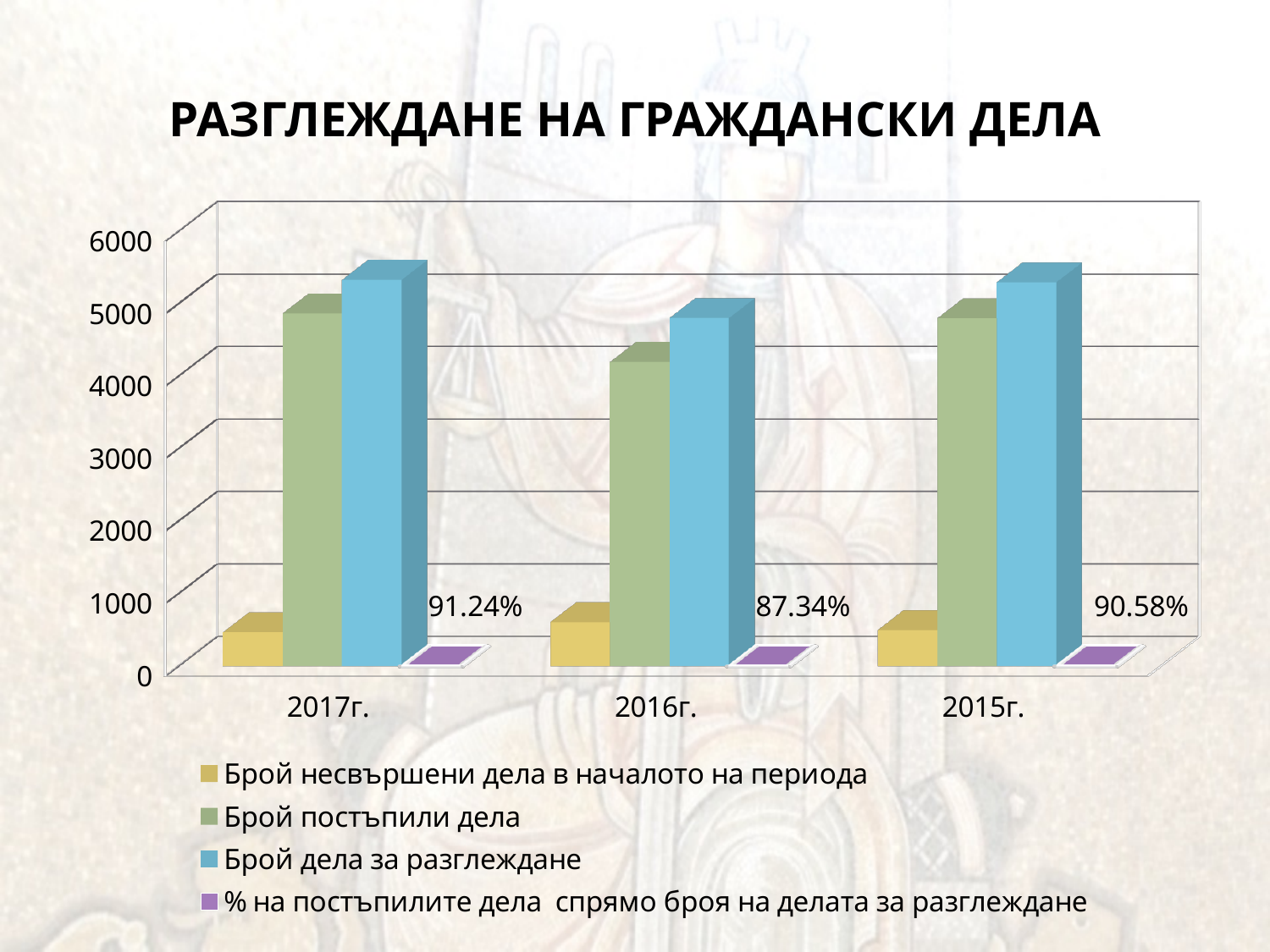
What is the value of "% на постъпилите дела спрямо броя на делата за разглеждане" for 2016г.? 87.34% What is the difference between the percentage values for 2017г. and 2016г.? 3.90% Is the value of "Брой дела за разглеждане" for 2017г. greater or less than 5000? greater What is the value of "% на постъпилите дела спрямо броя на делата за разглеждане" for 2017г.? 91.24% What is the title of the chart? РАЗГЛЕЖДАНЕ НА ГРАЖДАНСКИ ДЕЛА Which is larger: "Брой дела за разглеждане" for 2017г. or for 2016г.? 2017г. How many series does the legend list? 4 How many years are shown on the x axis? 3 Which year has the highest percentage of received cases relative to cases for consideration? 2017г. What is the value of "% на постъпилите дела спрямо броя на делата за разглеждане" for 2015г.? 90.58% Is the value of "Брой постъпили дела" for 2016г. greater or less than 5000? less Which year has the lowest percentage of received cases relative to cases for consideration? 2016г.